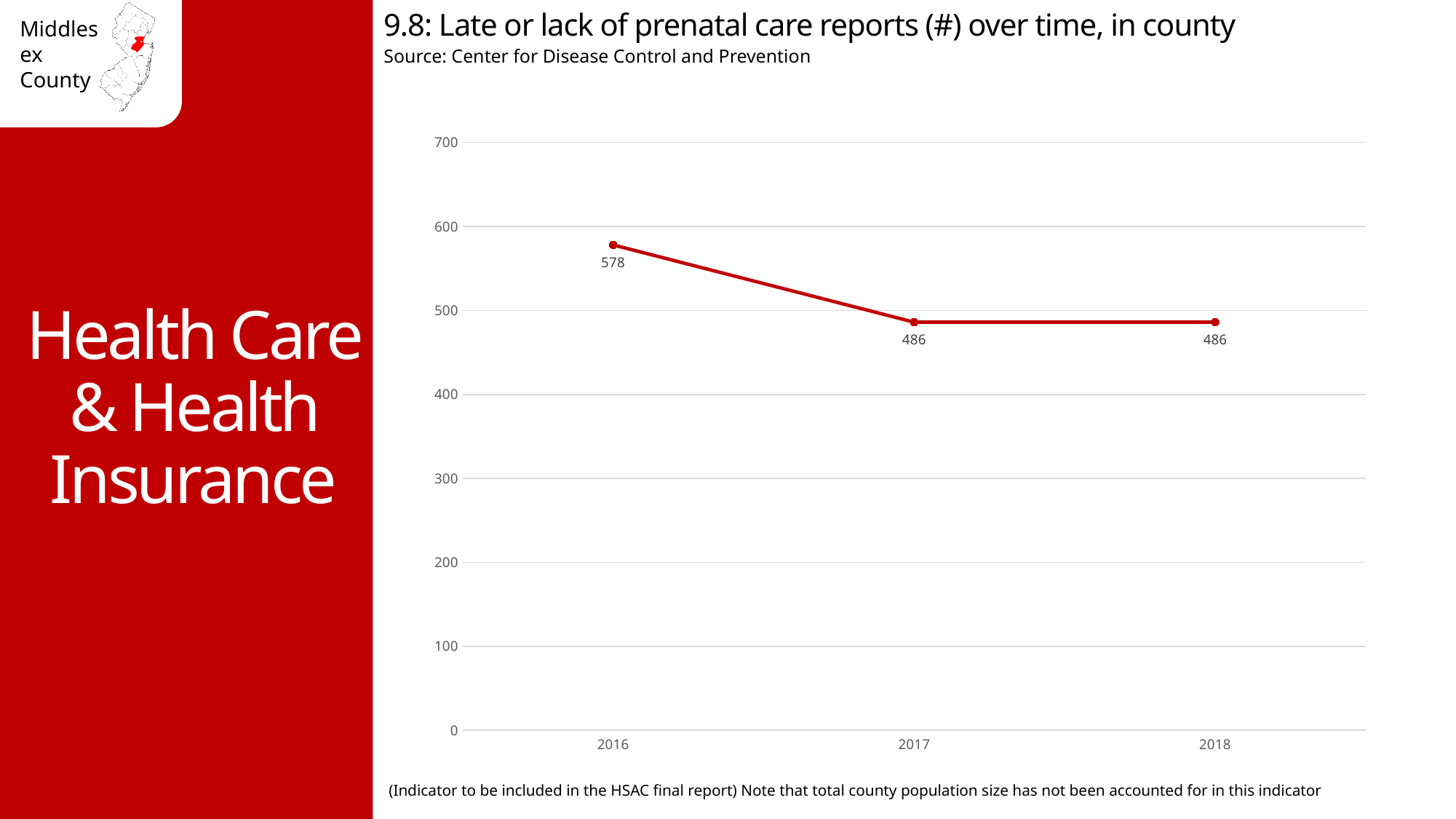
What is the number of late or lack of prenatal care reports in 2016? 578 What is the difference between the 2016 and 2017 values? 92 What is the source of the data shown in the chart? Center for Disease Control and Prevention How many years are plotted on the chart? 3 Is the value for 2016 greater or less than 500? greater What is the number of late or lack of prenatal care reports in 2018? 486 What kind of chart is shown on the slide? Line chart Do the values rise or fall from 2016 to 2017? Fall Which is larger, the value for 2016 or the value for 2018? 2016 What is the number of late or lack of prenatal care reports in 2017? 486 Which year has the highest number of late or lack of prenatal care reports? 2016 Is the value for 2017 greater or less than 500? less